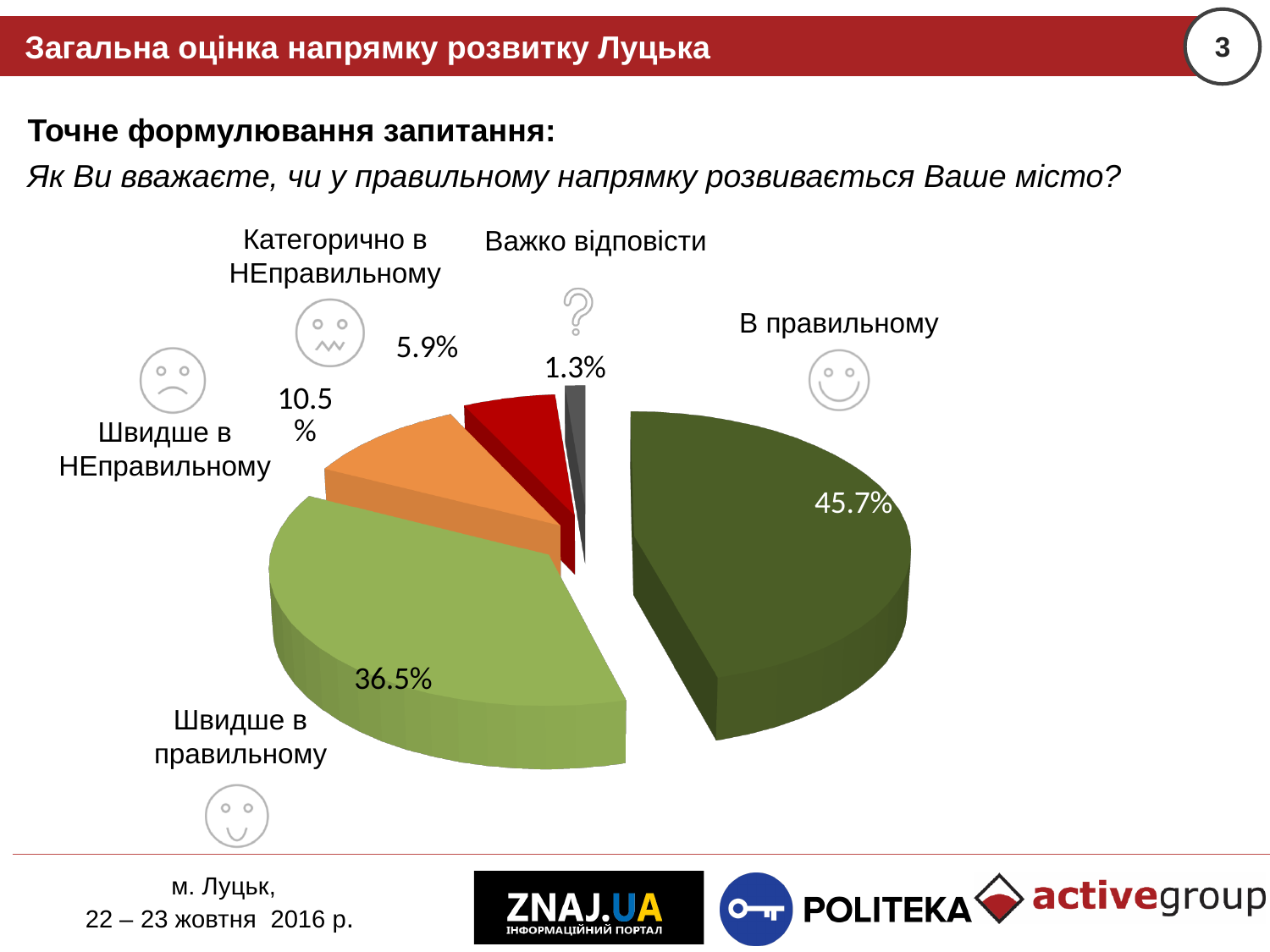
Which is larger: the share for "Швидше в НЕправильному" or for "Категорично в НЕправильному"? Швидше в НЕправильному What is the difference in percentage points between "В правильному" and "Швидше в правильному"? 9.2 Which answer option has the largest share in the pie chart? В правильному How many slices does the pie chart have? 5 What share of respondents answered "Швидше в НЕправильному"? 10.5% What share of respondents answered "В правильному"? 45.7% What type of chart is shown on the slide? Pie chart What share of respondents answered "Швидше в правильному"? 36.5% Which answer option has the smallest share in the pie chart? Важко відповісти What share of respondents answered "Категорично в НЕправильному"? 5.9% What share of respondents answered "Важко відповісти"? 1.3% What colour is the slice for "Швидше в НЕправильному"? Orange